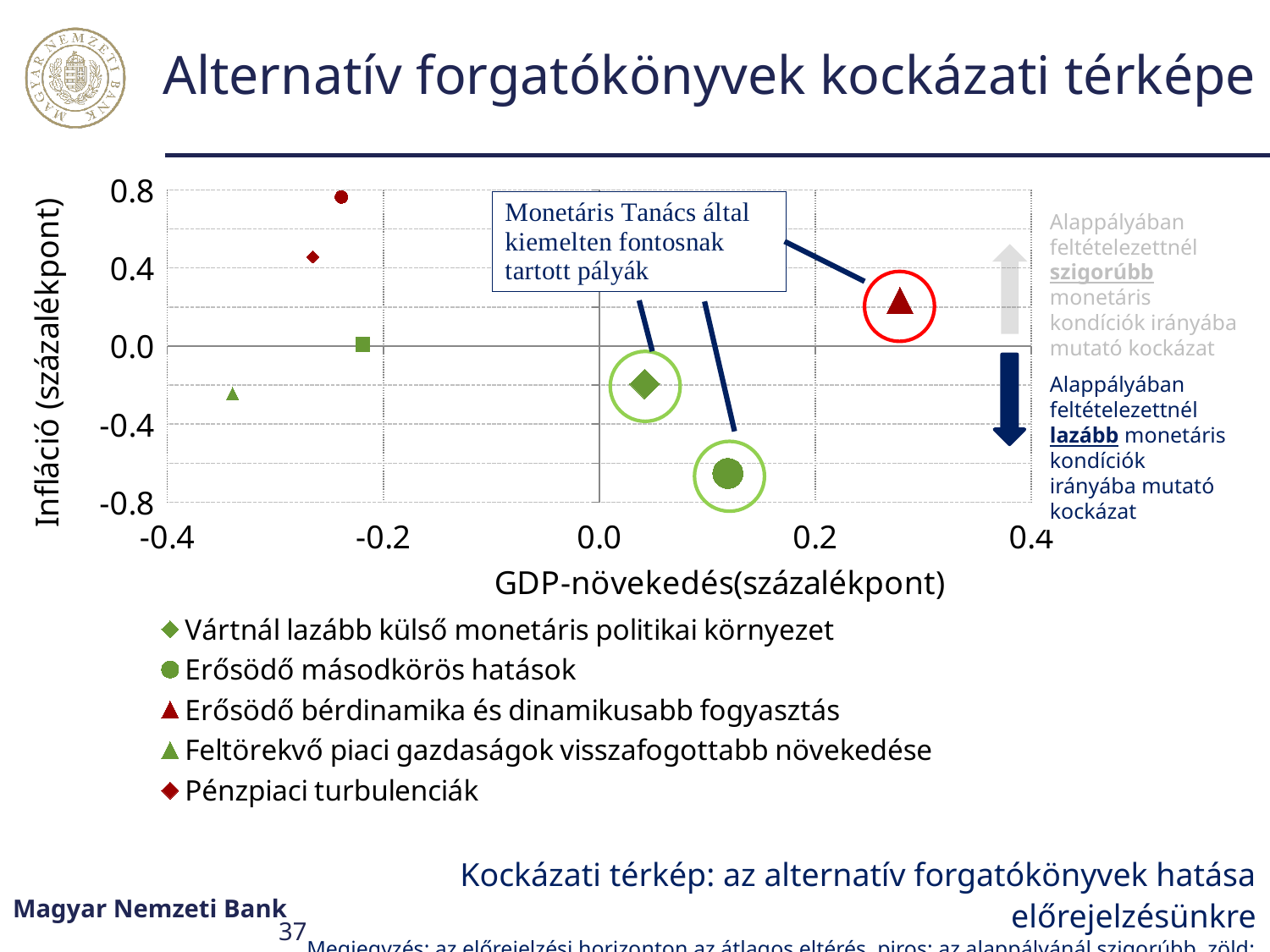
How many series does the legend list? 5 Is the GDP growth value for 'Erősödő bérdinamika és dinamikusabb fogyasztás' greater or less than 0.2? greater Which legend series has the highest GDP growth value? Erősödő bérdinamika és dinamikusabb fogyasztás Which legend series has the lowest inflation value? Erősödő másodkörös hatások What is the title of the horizontal axis? GDP-növekedés(százalékpont) Is the inflation value for 'Vártnál lazább külső monetáris politikai környezet' greater or less than 0.0? less Which has the higher inflation value: 'Erősödő bérdinamika és dinamikusabb fogyasztás' or 'Erősödő másodkörös hatások'? Erősödő bérdinamika és dinamikusabb fogyasztás What is the title of the vertical axis? Infláció (százalékpont) Is the inflation value for 'Pénzpiaci turbulenciák' greater or less than 0.0? greater What kind of chart is shown on the slide? scatter chart